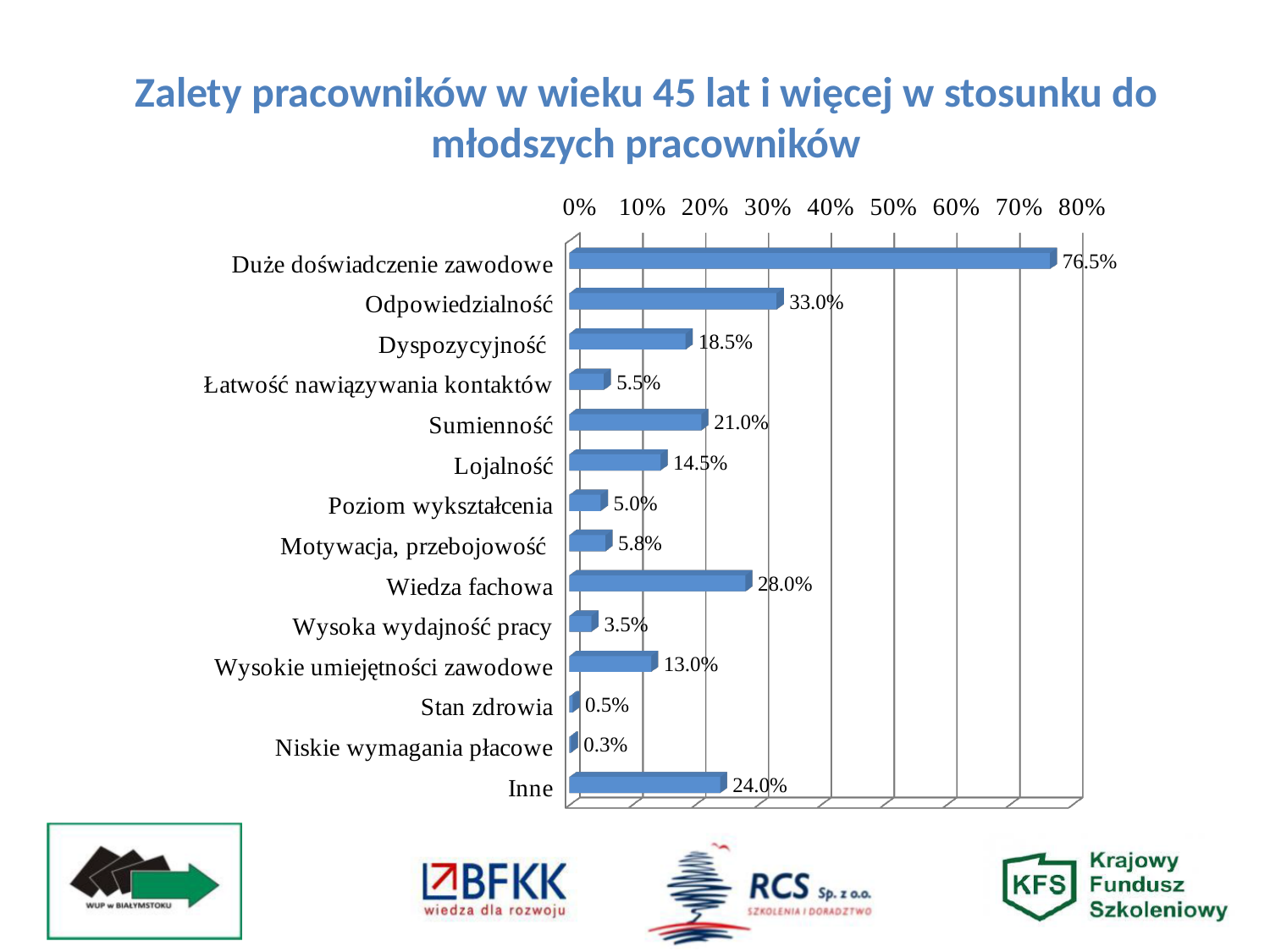
What is the value for Inne? 24.0% What is the title of the slide? Zalety pracowników w wieku 45 lat i więcej w stosunku do młodszych pracowników What is the difference between Odpowiedzialność and Dyspozycyjność? 14.5% What is the value for Wiedza fachowa? 28.0% Which category has the lowest value? Niskie wymagania płacowe Which category has the highest value? Duże doświadczenie zawodowe Is the value for Odpowiedzialność greater or less than 30%? greater What is the value for Niskie wymagania płacowe? 0.3% What kind of chart is shown on the slide? bar chart How many categories are shown in the chart? 14 What is the value for Duże doświadczenie zawodowe? 76.5% Which is larger, Sumienność or Lojalność? Sumienność